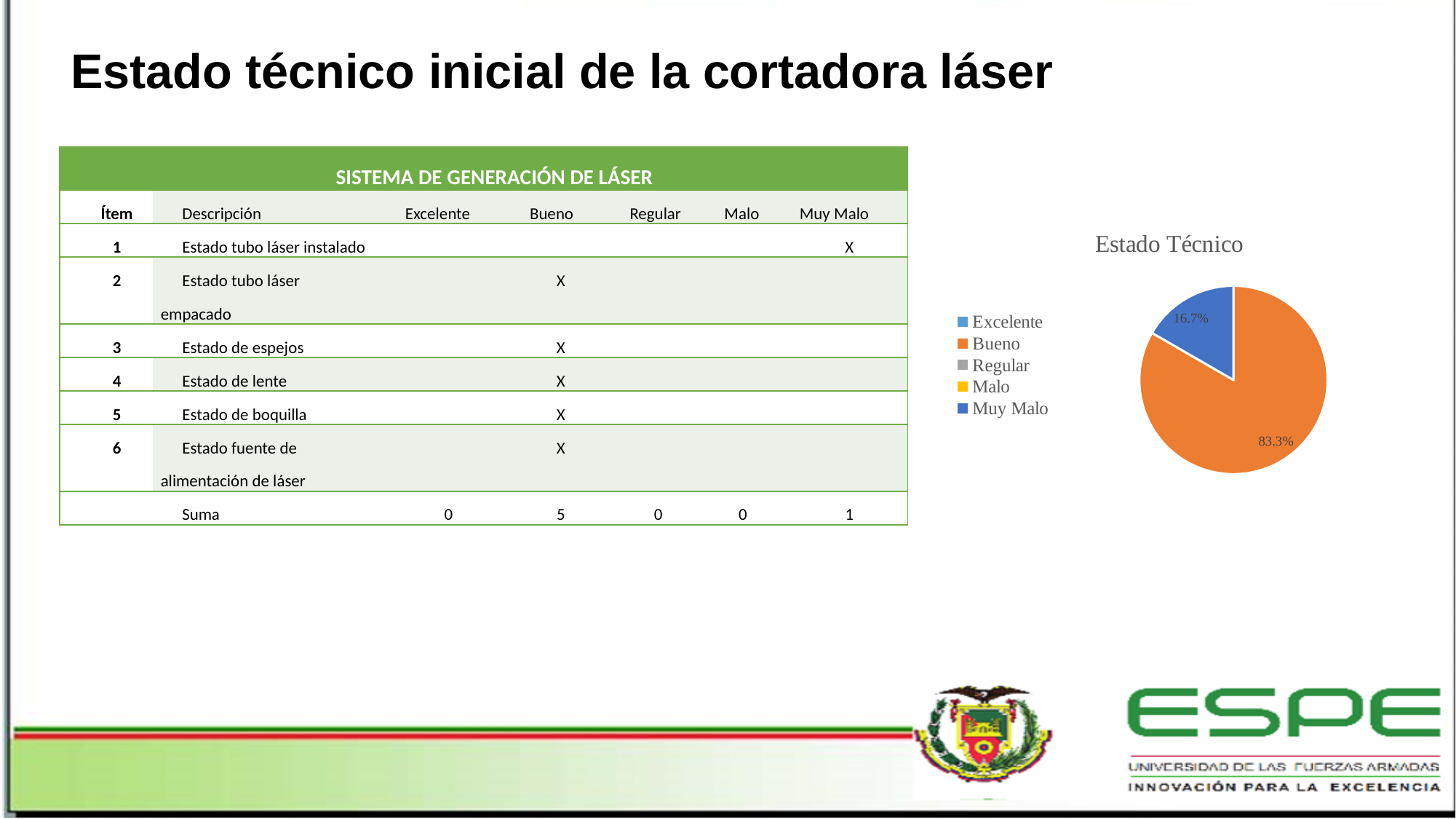
Which category has the largest slice of the pie? Bueno What is the title of the chart? Estado Técnico What share of the pie does Muy Malo take? 16.7% What colour is the Bueno slice? orange What is the difference in percentage points between the Bueno slice and the Muy Malo slice? 66.6 What share of the pie does Bueno take? 83.3% How many slices are visible in the pie? 2 What kind of chart is shown on the slide? pie chart How many entries does the chart's legend list? 5 Which of the two visible slices is larger, Bueno or Muy Malo? Bueno Is the share for Muy Malo greater or less than 50%? less